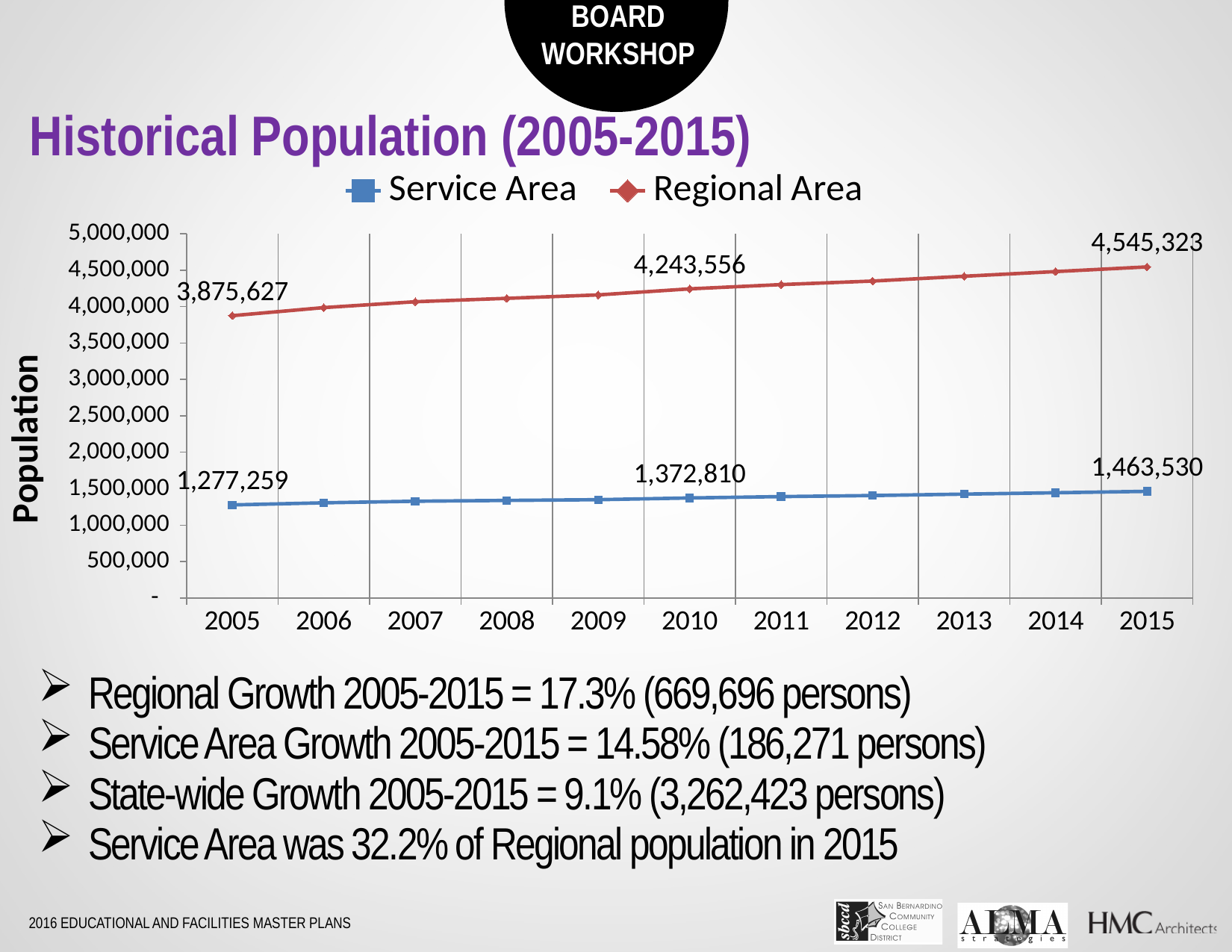
What was the Regional Area population in 2015? 4,545,323 By how much did the Regional Area population increase from 2005 to 2015? 669,696 What is the difference between the Regional Area and Service Area populations in 2010? 2,870,746 Is the Regional Area value for 2012 greater or less than 4,000,000? greater What was the Service Area population in 2015? 1,463,530 Which series has the higher population in 2015, Service Area or Regional Area? Regional Area What was the Service Area population in 2010? 1,372,810 Does the Service Area population rise or fall from 2005 to 2015? rise What was the Regional Area population in 2005? 3,875,627 How many years are plotted along the x axis? 11 How many series does the legend list? 2 What type of chart is shown on the slide? line chart